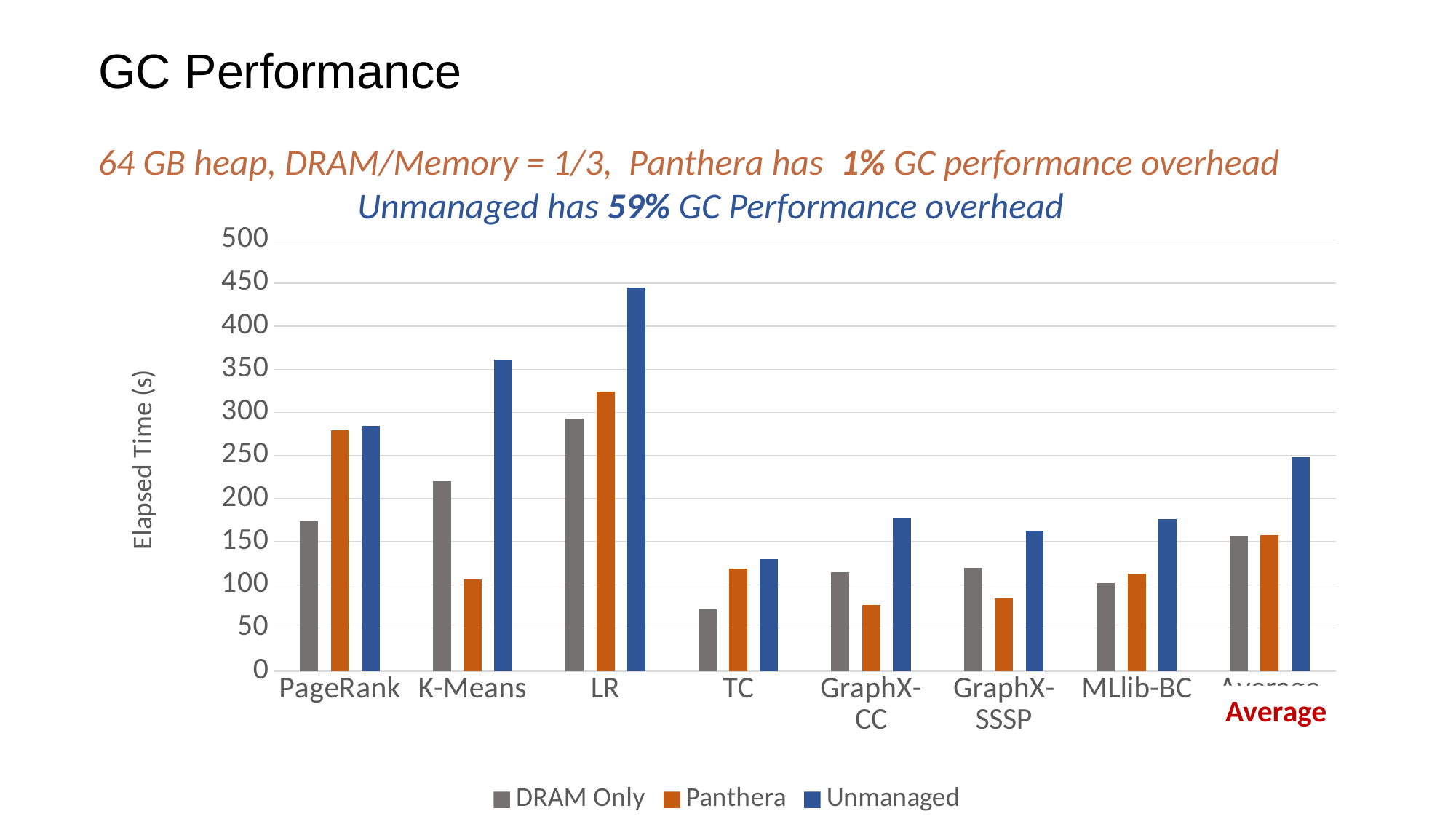
Is the Panthera value for K-Means greater or less than 150? less Is the DRAM Only value for TC greater or less than 100? less For which category is the DRAM Only bar the lowest? TC For which category is the Unmanaged bar the highest? LR What is the label on the y axis? Elapsed Time (s) For K-Means, which is larger: the DRAM Only value or the Panthera value? DRAM Only How many categories are shown along the x axis? 8 Is the Unmanaged value for Average greater or less than 200? greater How many series does the legend list? 3 Which has the larger Unmanaged value: LR or PageRank? LR What kind of chart is shown on the slide? bar chart